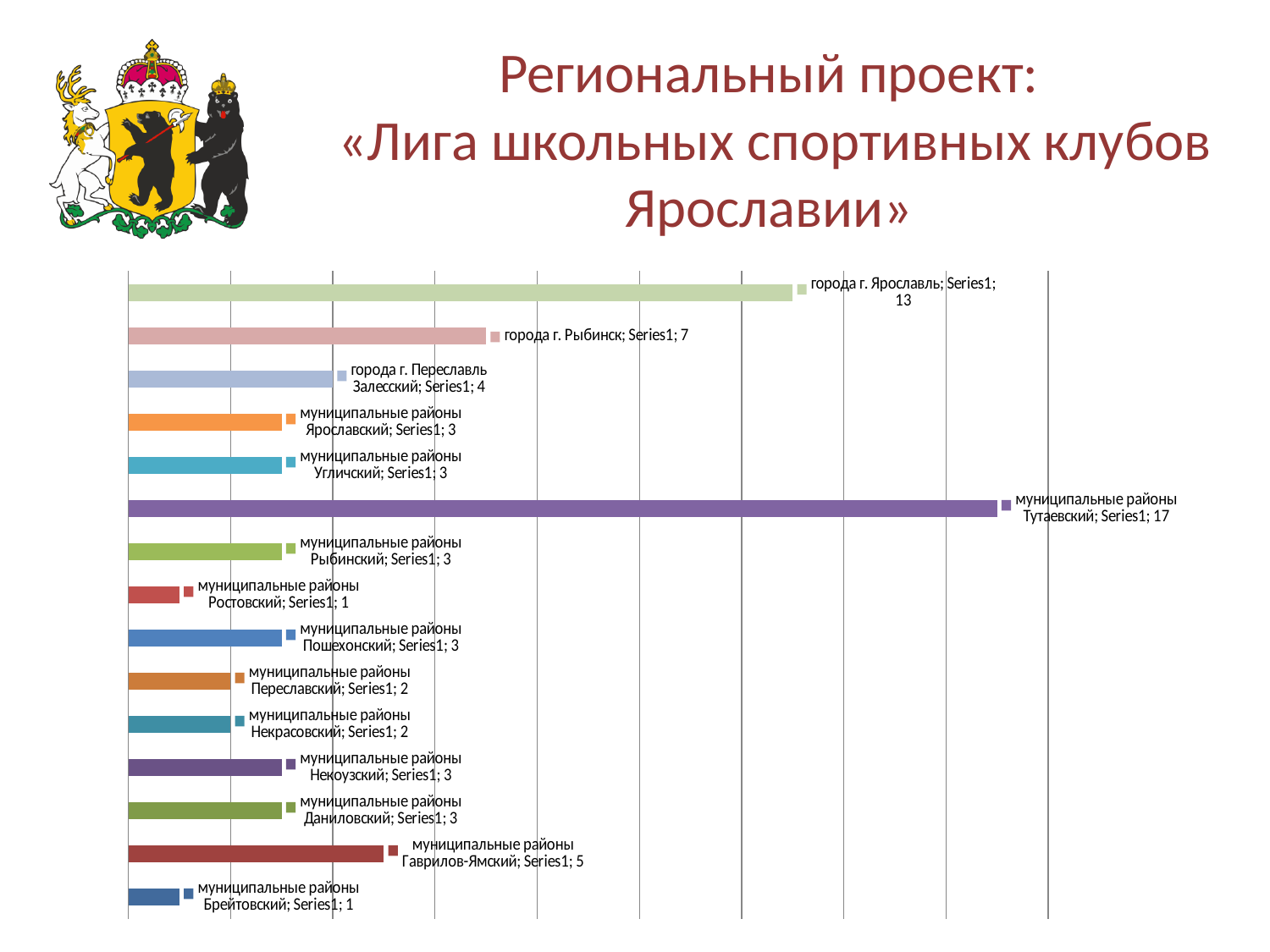
What kind of chart is shown on the slide? bar chart Which is larger, the value for города г. Ярославль or the value for города г. Рыбинск? города г. Ярославль Which is larger, the value for муниципальные районы Гаврилов-Ямский or the value for муниципальные районы Переславский? муниципальные районы Гаврилов-Ямский Which category has the highest value? муниципальные районы Тутаевский What is the value for муниципальные районы Гаврилов-Ямский? 5 What is the value for муниципальные районы Тутаевский? 17 What is the value for муниципальные районы Брейтовский? 1 What is the difference between the values for города г. Рыбинск and города г. Переславль Залесский? 3 What is the value for города г. Рыбинск? 7 How many categories are plotted in the chart? 15 What is the difference between the values for муниципальные районы Тутаевский and города г. Ярославль? 4 What is the value for города г. Ярославль? 13